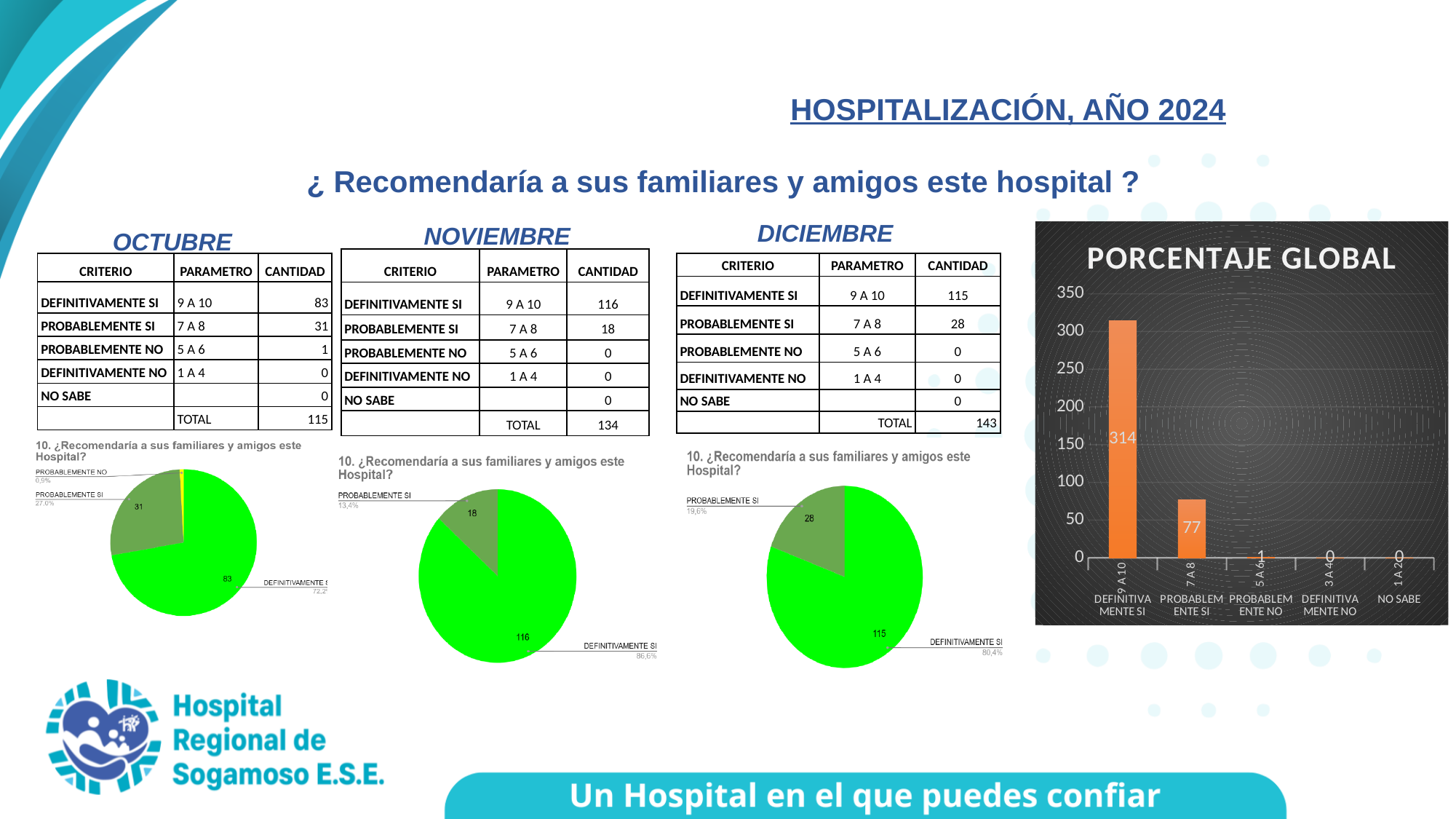
In the DICIEMBRE pie chart, what is the value for PROBABLEMENTE SI? 28 In the PORCENTAJE GLOBAL bar chart, which category has the highest value? DEFINITIVAMENTE SI In the PORCENTAJE GLOBAL bar chart, what is the value for PROBABLEMENTE NO? 1 In the NOVIEMBRE pie chart, what is the value for DEFINITIVAMENTE SI? 116 How many categories are shown in the PORCENTAJE GLOBAL bar chart? 5 In the OCTUBRE pie chart, what share of the pie is PROBABLEMENTE SI? 27,0% In the NOVIEMBRE pie chart, what share of the pie is DEFINITIVAMENTE SI? 86,6% In the PORCENTAJE GLOBAL bar chart, what is the difference between the values for DEFINITIVAMENTE SI and PROBABLEMENTE SI? 237 In the PORCENTAJE GLOBAL bar chart, what is the value for PROBABLEMENTE SI? 77 In the PORCENTAJE GLOBAL bar chart, what is the value for DEFINITIVAMENTE SI? 314 In the PORCENTAJE GLOBAL bar chart, do the values rise or fall from left to right? fall What kind of chart is the PORCENTAJE GLOBAL chart? bar chart